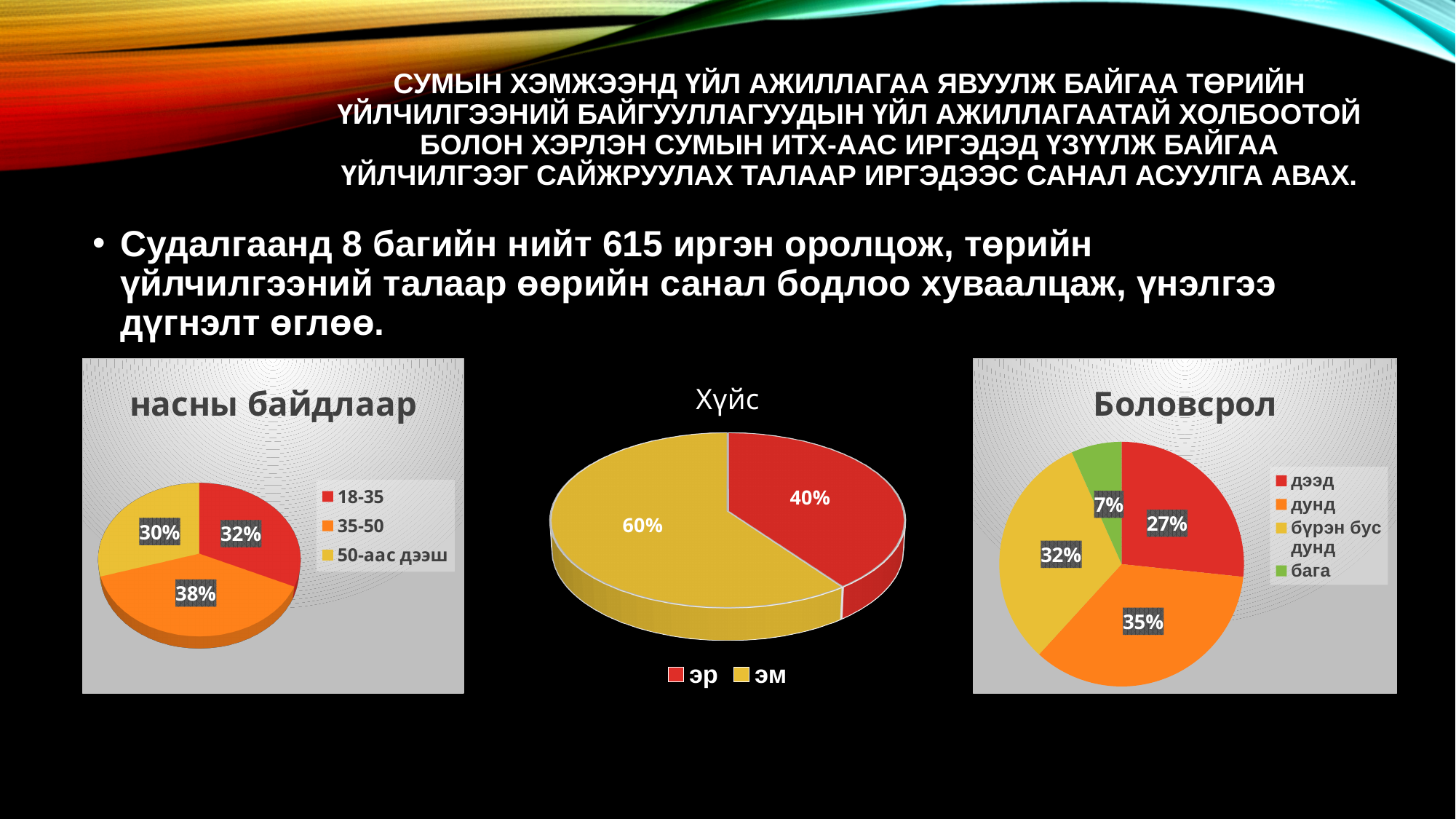
In the 'Боловсрол' chart, which category has the largest share? дунд In the 'Хүйс' chart, which is larger, 'эр' or 'эм'? эм In the 'Боловсрол' chart, what is the difference between the 'дунд' share and the 'дээд' share? 8% In the 'насны байдлаар' chart, which category has the smallest share? 50-аас дээш In the 'Боловсрол' chart, what colour represents 'бага'? Green In the 'насны байдлаар' chart, what is the difference between the 35-50 share and the 18-35 share? 6% In the 'Боловсрол' chart, what percentage is shown for 'бага'? 7% How many series does the legend of the 'Хүйс' chart list? 2 How many categories are shown in the 'Боловсрол' chart? 4 In the 'насны байдлаар' chart, what percentage is shown for the 35-50 category? 38% In the 'Хүйс' chart, what percentage is shown for 'эм'? 60% What type of chart is the 'Хүйс' chart? Pie chart